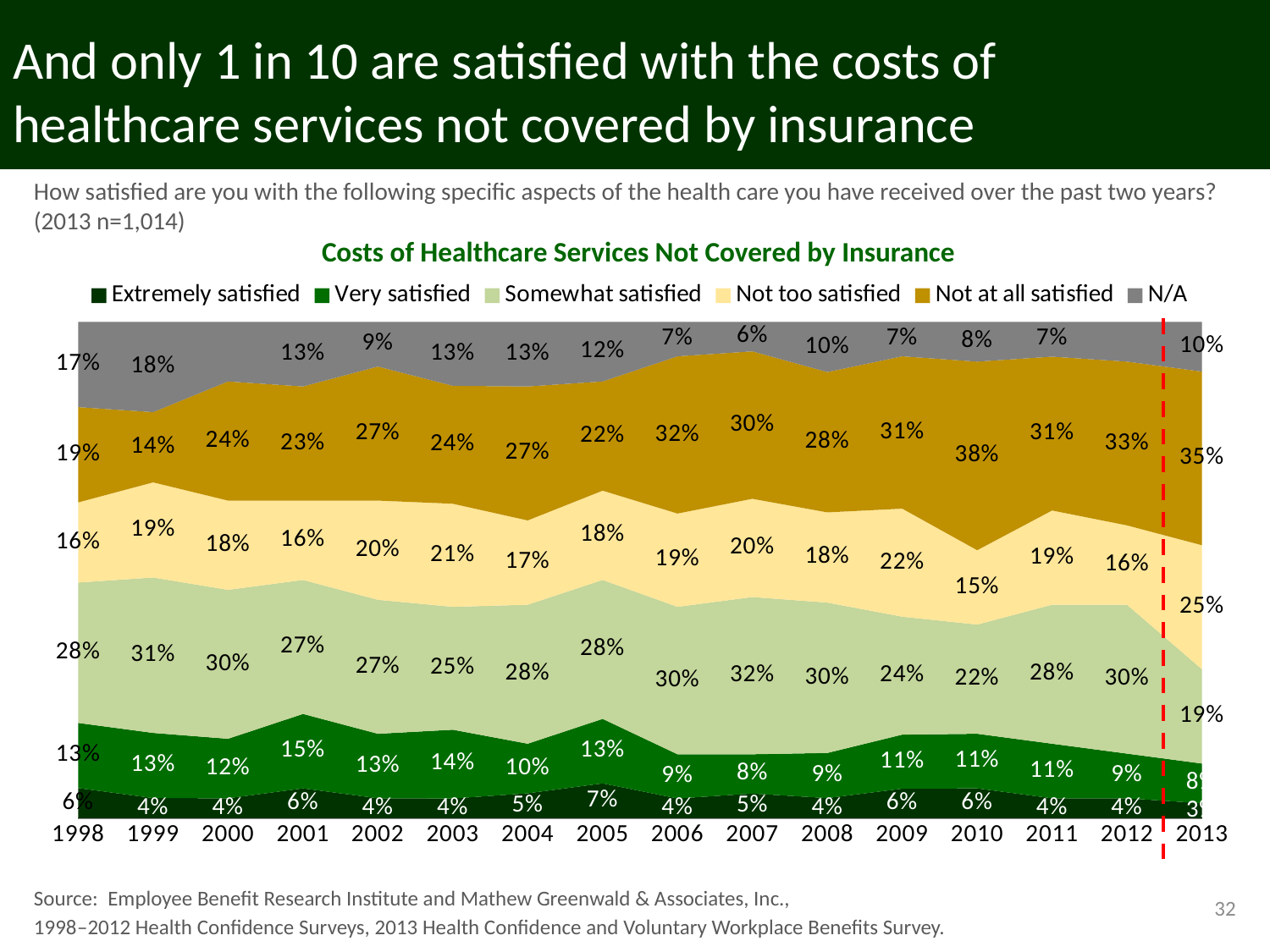
How many years are shown along the x axis? 16 What is the value for 'Not at all satisfied' in 2013? 35% Which series is shown in grey at the top of the chart? N/A What is the value for 'Not too satisfied' in 2010? 15% How many series does the legend list? 6 In which year is the 'Not at all satisfied' value highest? 2010 In which year is the 'Not at all satisfied' value lowest? 1999 Which is larger, the 'Very satisfied' value in 2001 or in 2004? 2001 What type of chart is shown on the slide? Stacked area chart What is the title of the chart? Costs of Healthcare Services Not Covered by Insurance What is the value for 'Somewhat satisfied' in 2007? 32% What is the difference between the 'Somewhat satisfied' values in 2012 and 2013? 11 percentage points